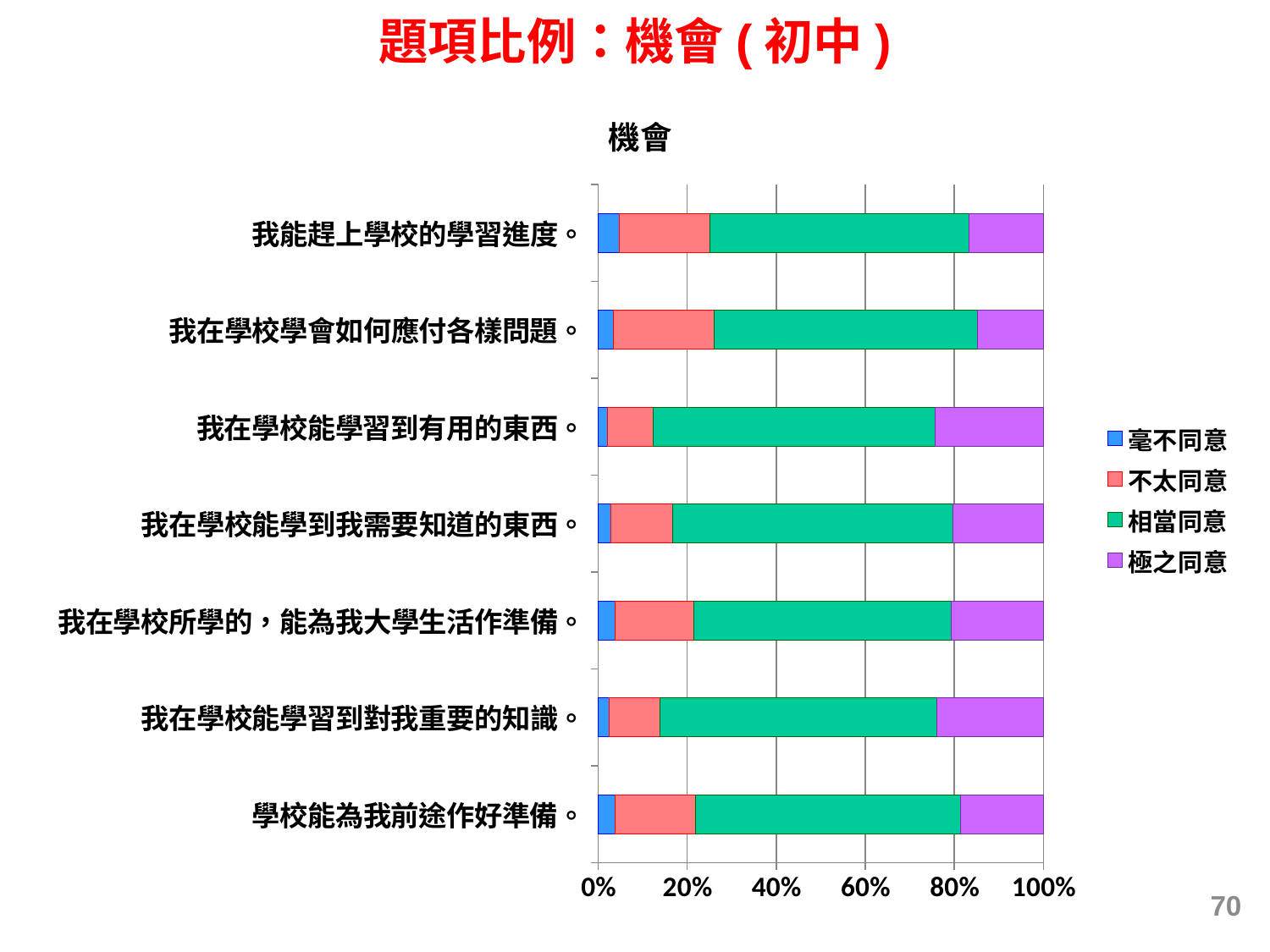
Is the 不太同意 value for 我在學校能學習到有用的東西。 greater or less than 20%? less How many statements (categories) are plotted in the chart? 7 What is the title of the chart? 機會 How many series does the legend list? 4 Which has the larger 極之同意 share: 我在學校能學習到有用的東西。 or 我在學校學會如何應付各樣問題。? 我在學校能學習到有用的東西。 Which colour represents 相當同意 in the chart? Green Which has the larger 不太同意 share: 我能趕上學校的學習進度。 or 我在學校能學習到有用的東西。? 我能趕上學校的學習進度。 What kind of chart is shown on the slide? Stacked bar chart Is the 極之同意 value for 我在學校學會如何應付各樣問題。 greater or less than 20%? less Is the 相當同意 value for 我在學校能學習到有用的東西。 greater or less than 60%? greater What is the total of each stacked bar in the chart? 100%